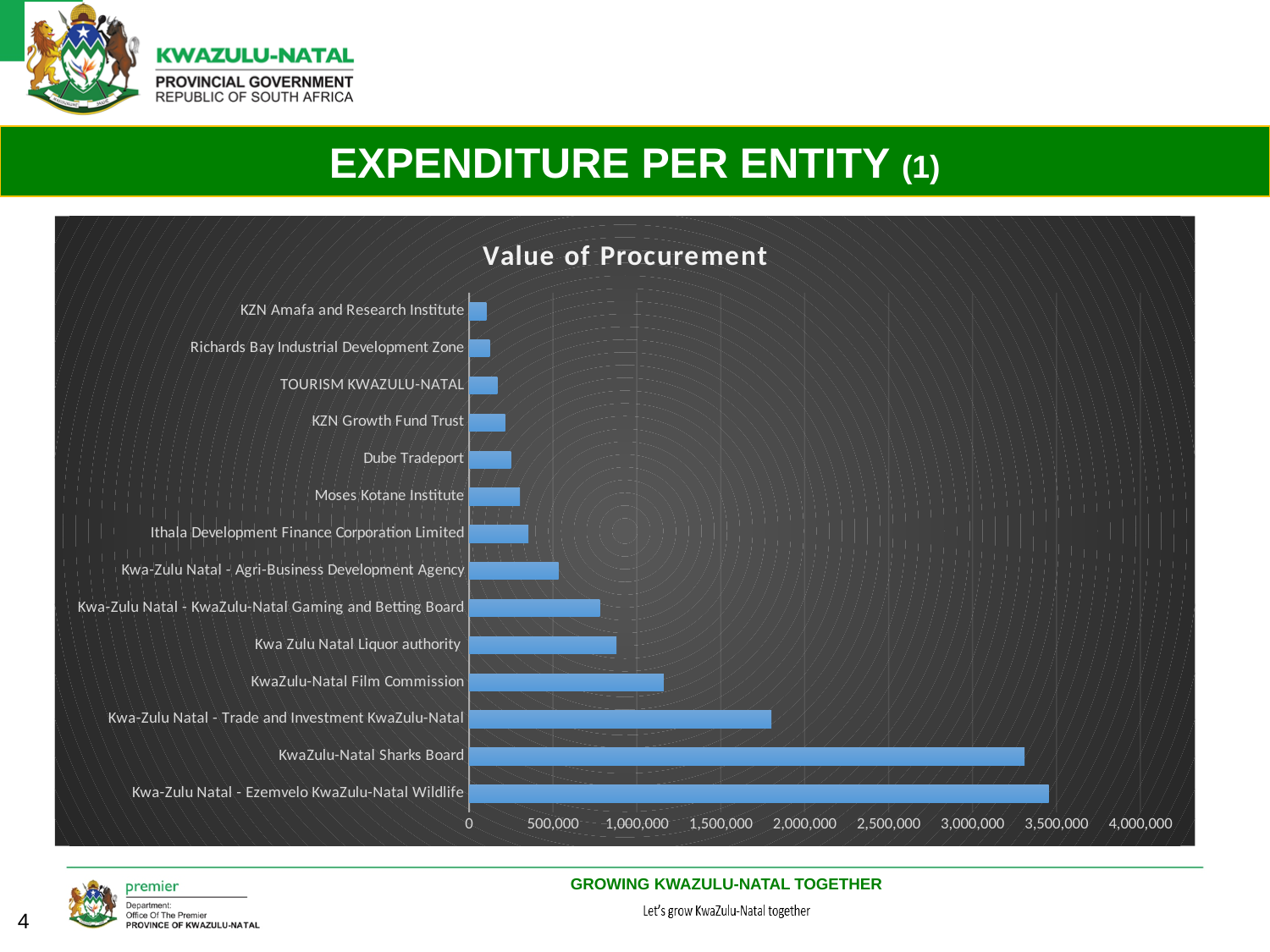
Is the value for KwaZulu-Natal Film Commission greater or less than 1,000,000? greater How many entities are plotted in the chart? 14 Which has a larger value of procurement, KwaZulu-Natal Sharks Board or Kwa-Zulu Natal - Trade and Investment KwaZulu-Natal? KwaZulu-Natal Sharks Board Which entity has the lowest value of procurement? KZN Amafa and Research Institute Is the value for Dube Tradeport greater or less than 500,000? less Which entity has the highest value of procurement? Kwa-Zulu Natal - Ezemvelo KwaZulu-Natal Wildlife Is the value for Kwa-Zulu Natal - KwaZulu-Natal Gaming and Betting Board greater or less than 1,000,000? less What kind of chart is shown on the slide? bar chart What is the title of the chart? Value of Procurement Which has a larger value of procurement, KwaZulu-Natal Film Commission or Kwa Zulu Natal Liquor authority? KwaZulu-Natal Film Commission